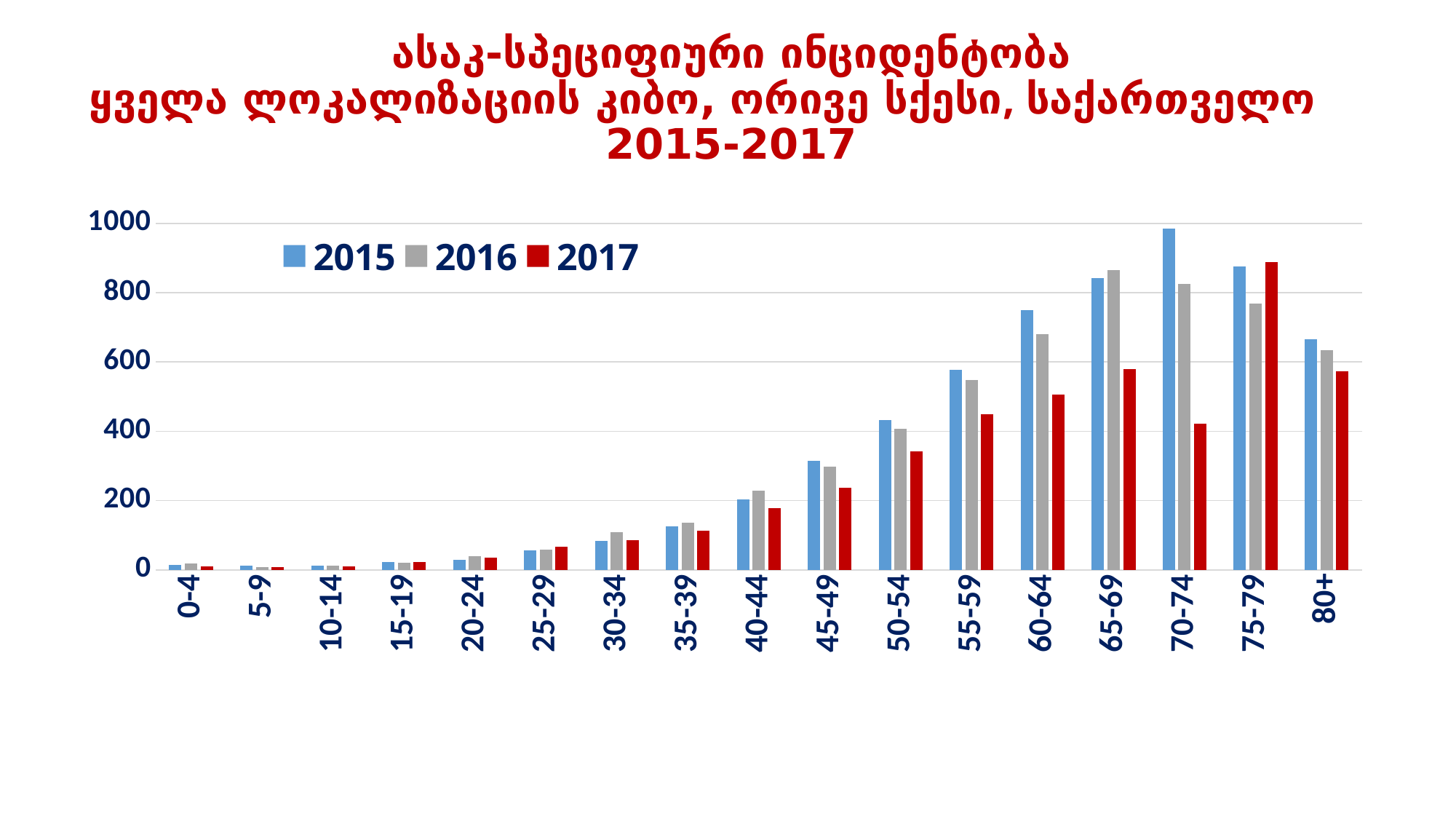
Which age group has the highest value for the 2015 series? 70-74 What kind of chart is shown on the slide? bar chart Is the 2017 value for the 70-74 age group greater or less than 600? less How many age-group categories are shown on the x axis? 17 Do the 2015 values generally rise or fall from the 0-4 age group to the 70-74 age group? rise Is the 2015 value for the 70-74 age group greater or less than 900? greater How many series does the legend list? 3 For the 75-79 age group, which series has the larger value, 2016 or 2017? 2017 For the 70-74 age group, which series has the larger value, 2015 or 2017? 2015 Is the 2017 value for the 50-54 age group greater or less than 400? less Which age group has the highest value for the 2017 series? 75-79